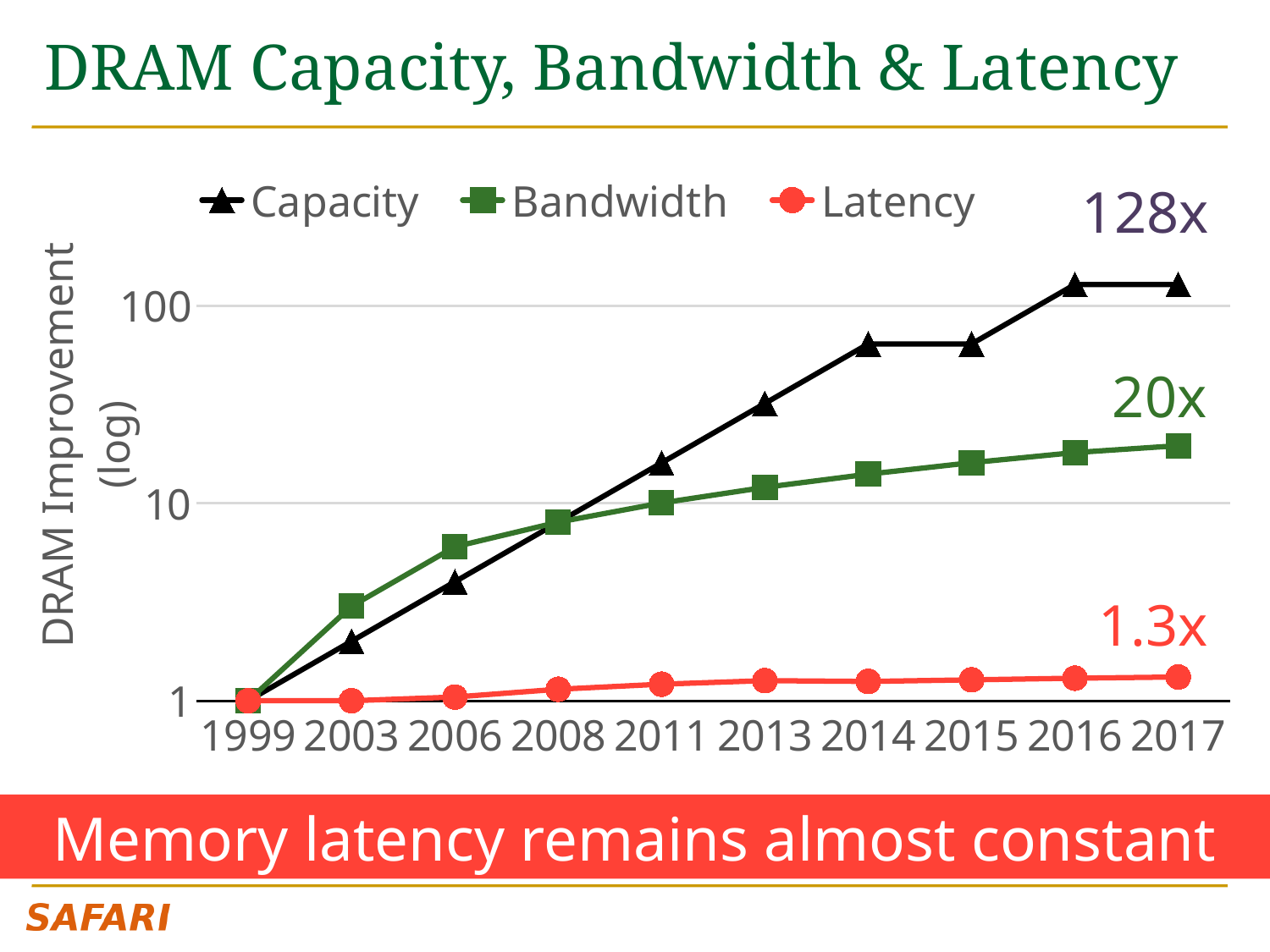
What improvement factor is labelled for Latency at the end of the chart? 1.3x What improvement factor is labelled for Bandwidth at the end of the chart? 20x What kind of chart is shown on the slide? line chart What improvement factor is labelled for Capacity at the end of the chart? 128x Which series has the lowest value in 2017? Latency In 2006, which is larger: Capacity or Bandwidth? Bandwidth How many series does the legend list? 3 What is the label of the y axis? DRAM Improvement (log) Does the Capacity series rise or fall from 1999 to 2017? rise Which series has the highest value in 2017? Capacity How many years are shown on the x axis? 10 Is the Capacity value in 2017 greater or less than 100? greater